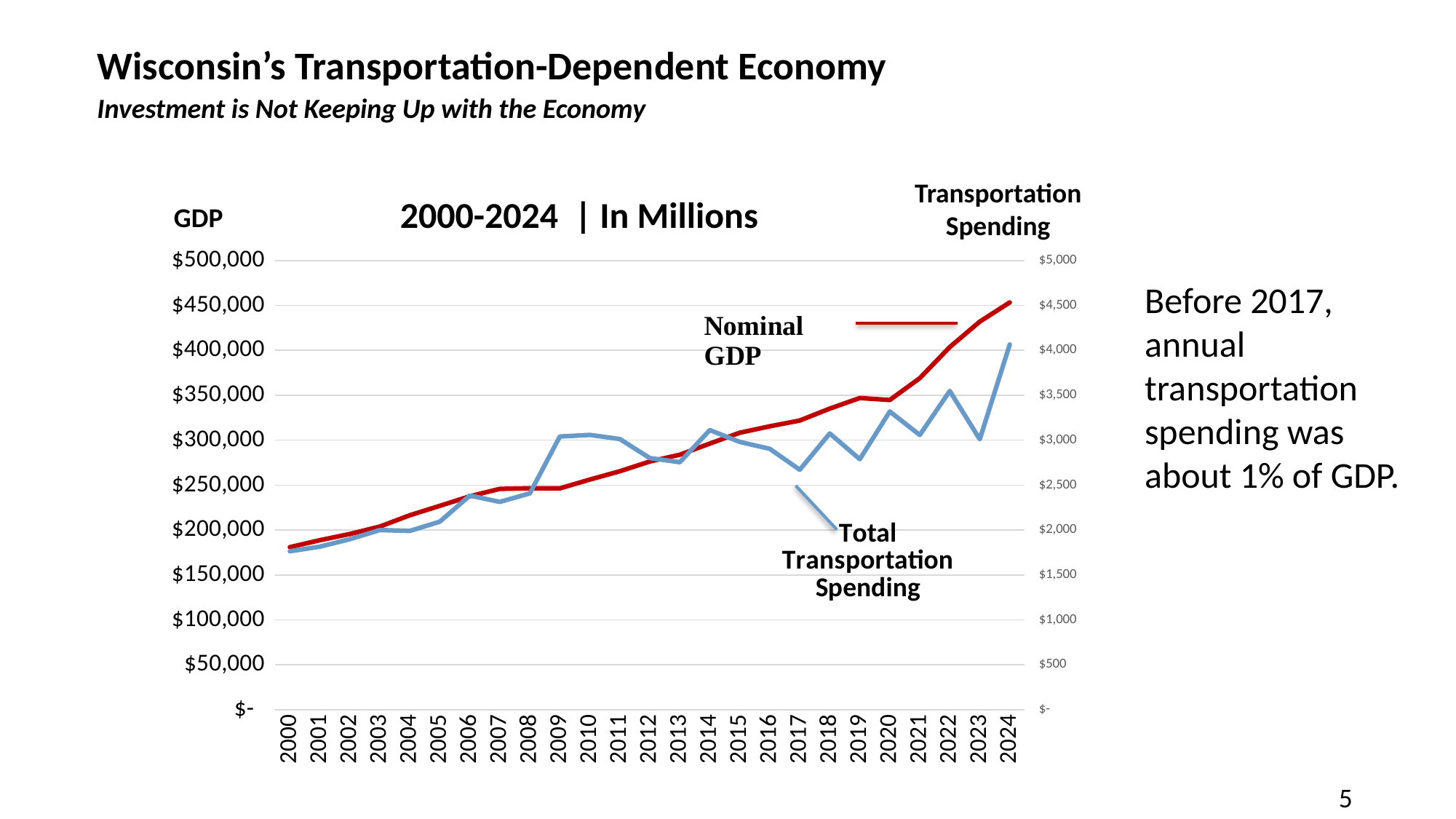
What colour is the Nominal GDP line on the chart? Red What kind of chart is shown on the slide? Line chart In which year is Total Transportation Spending highest? 2024 Is the Nominal GDP value for 2024 greater or less than $400,000? greater Is the Total Transportation Spending value for 2023 greater or less than $3,500? less Does Nominal GDP generally rise or fall from 2000 to 2024? Rise How many series are plotted on the chart? 2 How many years are shown along the x axis of the chart? 25 In which year is Total Transportation Spending lowest? 2000 In which year is Nominal GDP highest? 2024 Is the Nominal GDP value for 2000 greater or less than $200,000? less